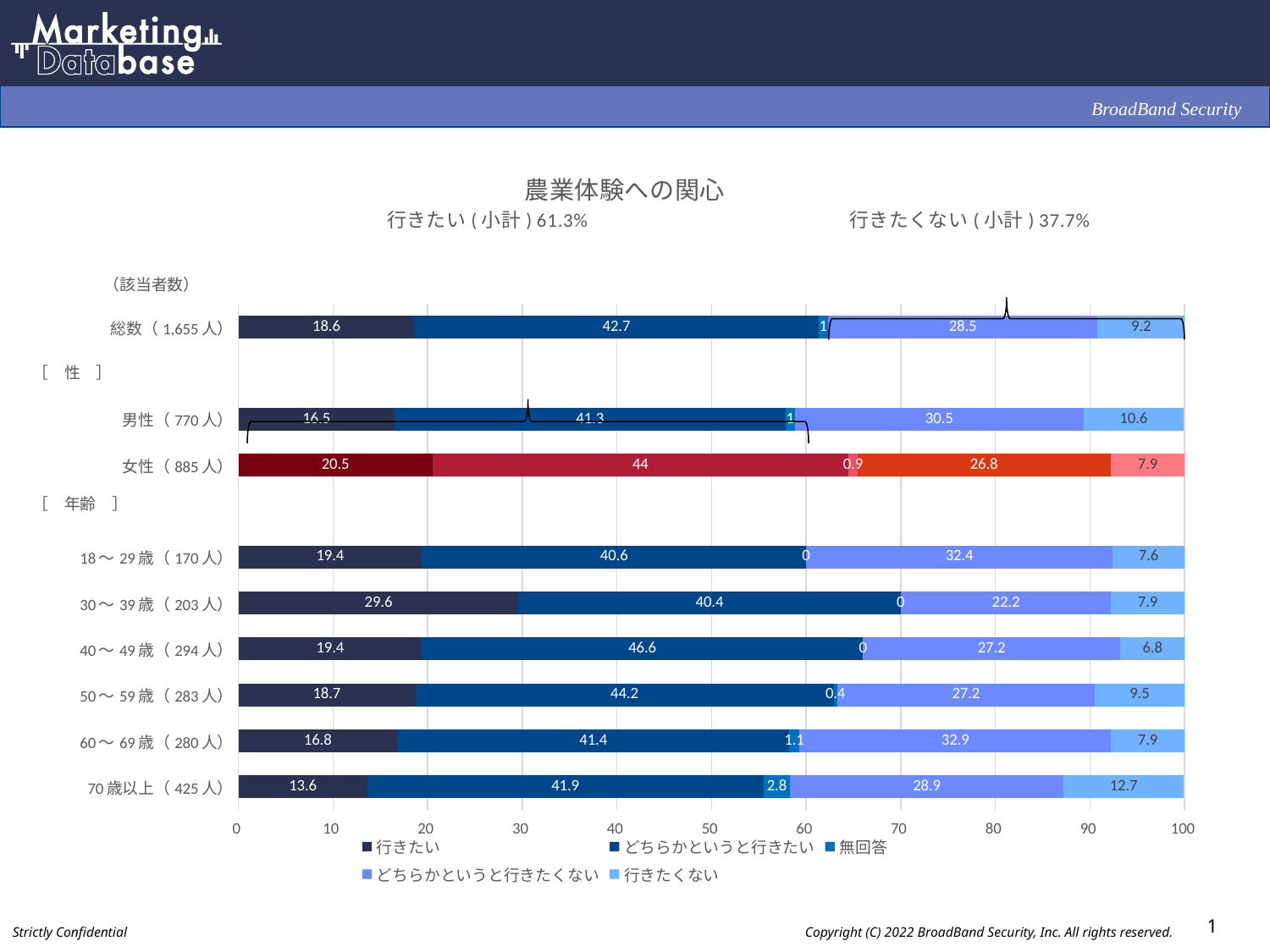
What is the どちらかというと行きたい value for 40～49歳 (294人)? 46.6 What type of chart is shown on the slide? stacked bar chart What is the 行きたくない value for 70歳以上 (425人)? 12.7 What is the 行きたい value for 30～39歳 (203人)? 29.6 Which category has the highest 行きたい value? 30～39歳 (203人) What is the difference between the 行きたくない values for 70歳以上 (425人) and 40～49歳 (294人)? 5.9 How many series does the legend list? 5 What is the title of the chart? 農業体験への関心 Which is larger, the どちらかというと行きたくない value for 18～29歳 (170人) or for 60～69歳 (280人)? 60～69歳 (280人) What is the 無回答 value for 70歳以上 (425人)? 2.8 What is the どちらかというと行きたくない value for 女性 (885人)? 26.8 Which category has the lowest 行きたい value? 70歳以上 (425人)